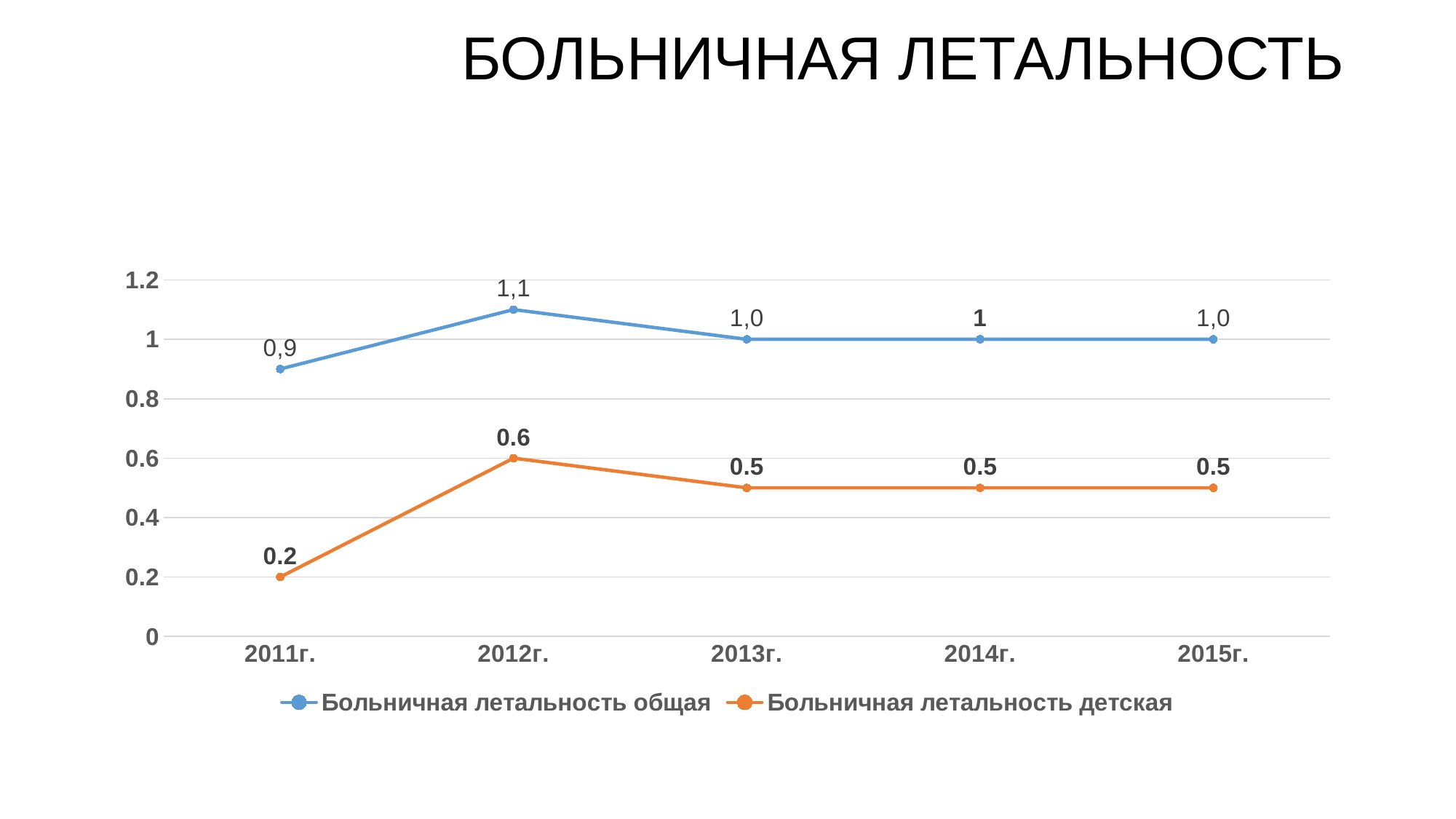
What is the value of Больничная летальность общая in 2011г.? 0,9 What is the difference between Больничная летальность детская in 2012г. and in 2011г.? 0.4 What is the value of Больничная летальность общая in 2012г.? 1,1 Which series has the larger value in 2013г., Больничная летальность общая or Больничная летальность детская? Больничная летальность общая What type of chart is shown on the slide? line chart In which year is Больничная летальность детская highest? 2012г. How many years are shown on the x axis? 5 In which year is Больничная летальность общая lowest? 2011г. What is the title of the chart? БОЛЬНИЧНАЯ ЛЕТАЛЬНОСТЬ What is the value of Больничная летальность детская in 2015г.? 0.5 How many series does the legend list? 2 What is the value of Больничная летальность детская in 2011г.? 0.2